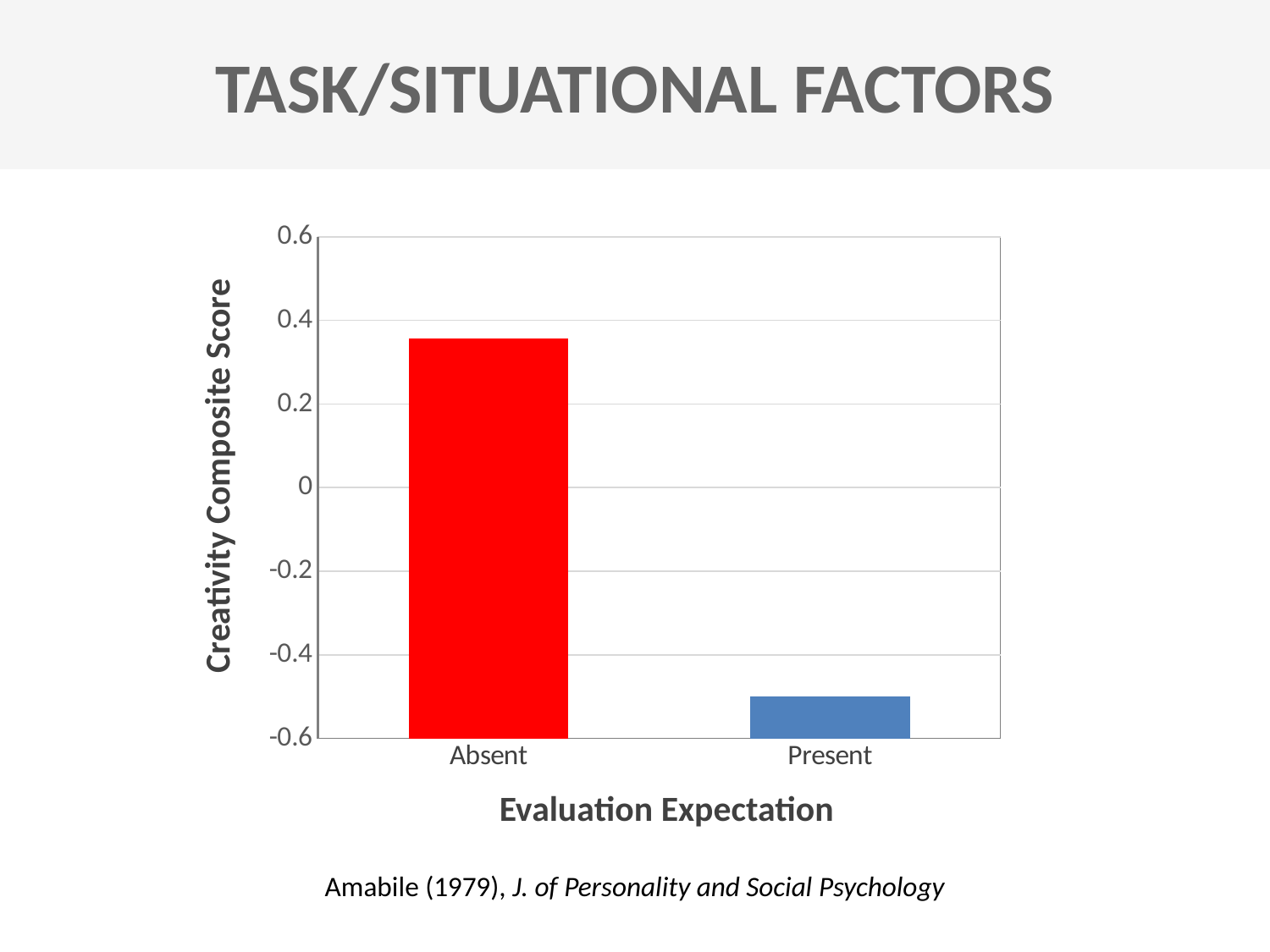
Which has the larger Creativity Composite Score, Absent or Present? Absent What kind of chart is shown on the slide? bar chart Is the value for Absent greater or less than 0.4? less Is the value for Absent greater or less than 0.2? greater What is the title of the y axis? Creativity Composite Score Which category has the highest Creativity Composite Score? Absent Is the value for Present greater or less than -0.4? less How many categories are shown on the x axis? 2 What is the title of the x axis? Evaluation Expectation Which category has the lowest Creativity Composite Score? Present